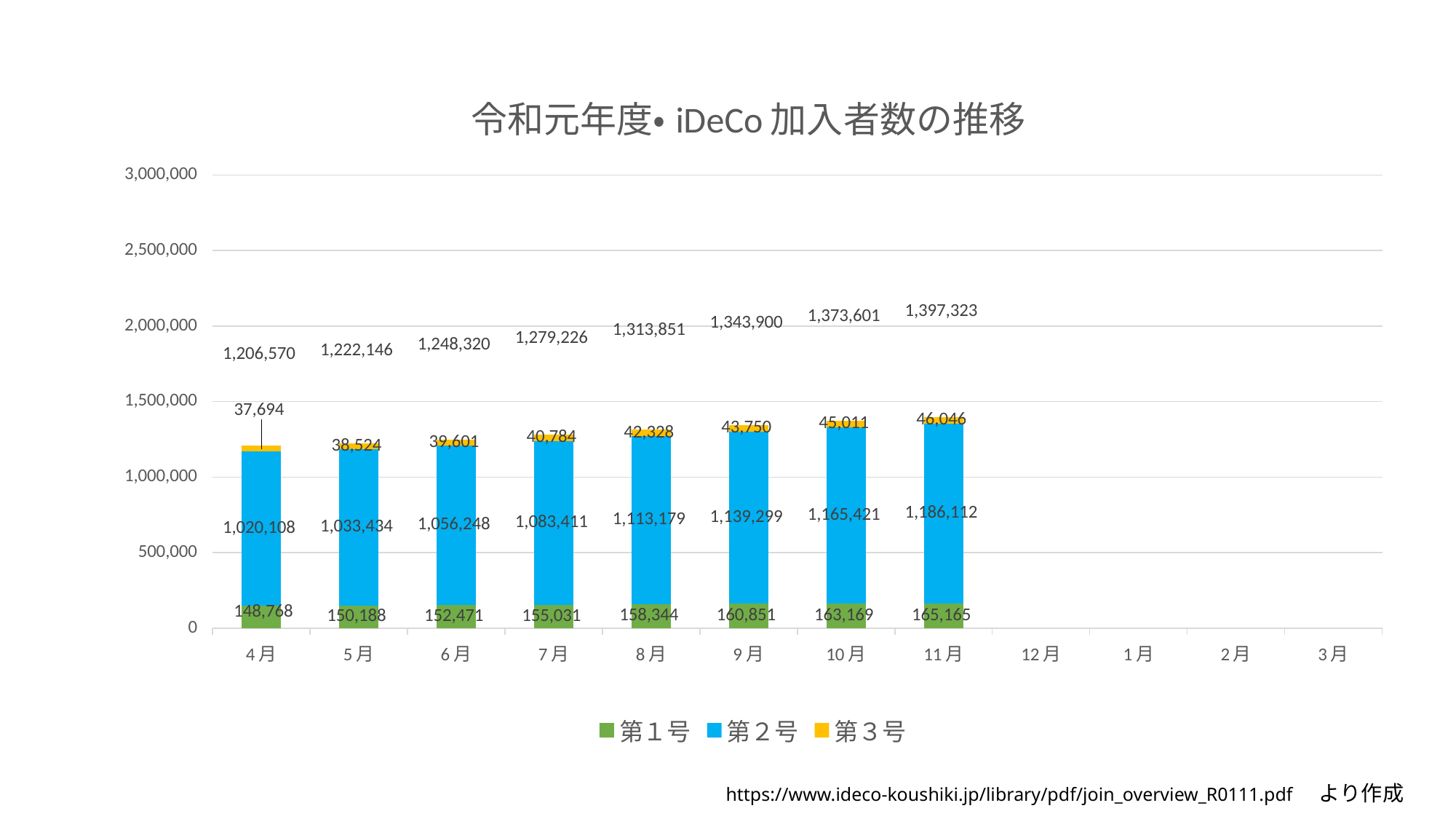
What is the value of 第２号 for 7月? 1,083,411 Which month has the highest total number of iDeCo subscribers? 11月 What type of chart is shown on the slide? stacked bar chart How many series does the legend list? 3 Which is larger, the 第３号 value for 8月 or for 6月? 8月 Do the total values rise or fall from 4月 to 11月? rise What is the value of 第３号 for 11月? 46,046 What is the difference between the 第１号 values for 11月 and 4月? 16,397 What is the title of the chart? 令和元年度• iDeCo 加入者数の推移 What is the total of the stacked bar for 9月? 1,343,900 What is the value of 第１号 for 4月? 148,768 Which month has the lowest value for 第２号 among the months with data? 4月